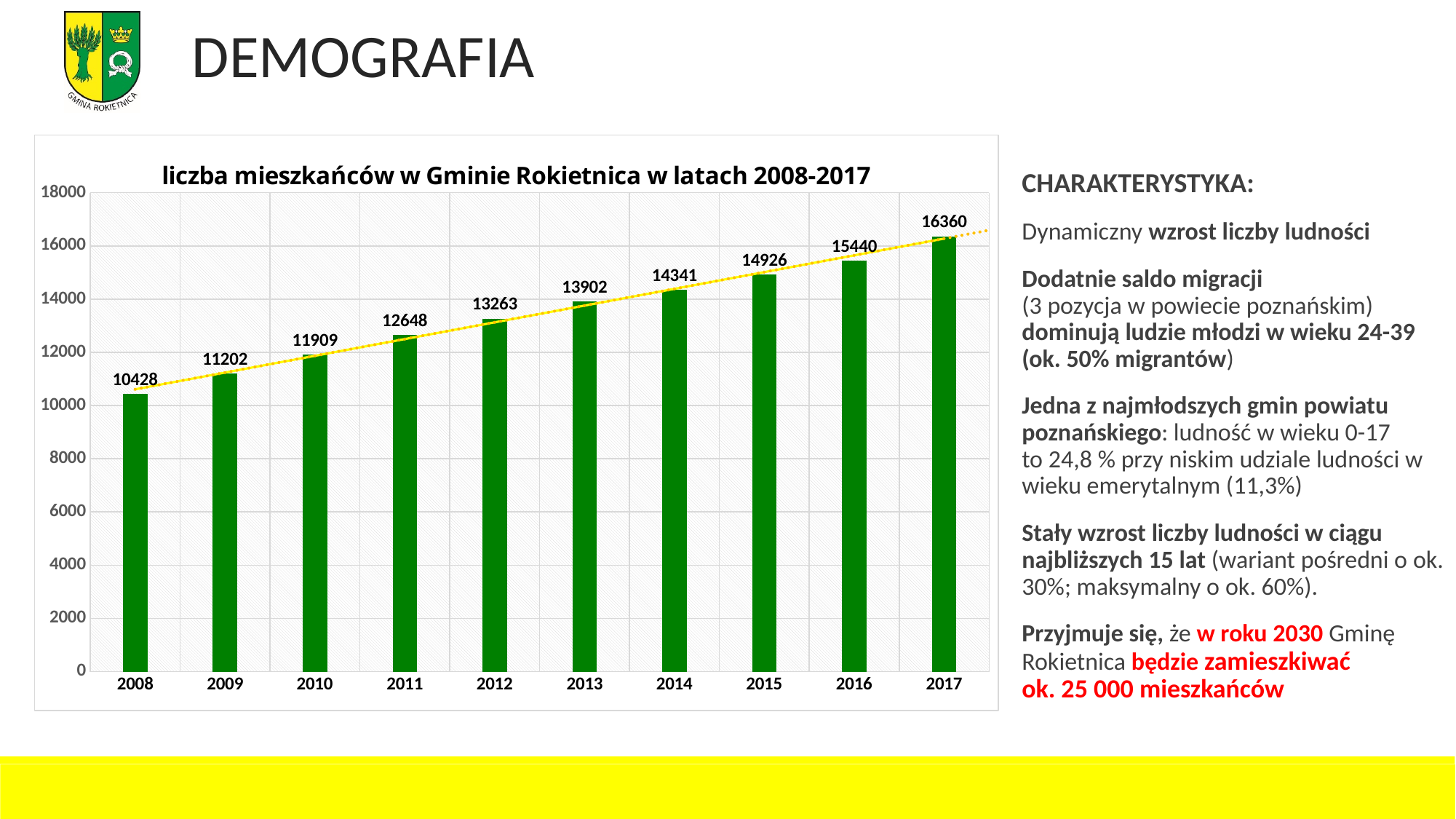
What is the difference between the number of inhabitants in 2015 and in 2014? 585 Do the values rise or fall from 2008 to 2017? rise What is the number of inhabitants shown for 2017? 16360 What kind of chart is shown on the slide? bar chart What is the number of inhabitants shown for 2013? 13902 What is the difference between the number of inhabitants in 2017 and in 2008? 5932 Which year has more inhabitants, 2010 or 2012? 2012 Which year has the lowest number of inhabitants? 2008 What is the number of inhabitants shown for 2008? 10428 Which year has the highest number of inhabitants? 2017 How many years are shown on the x axis? 10 Is the value for 2011 greater or less than 12000? greater